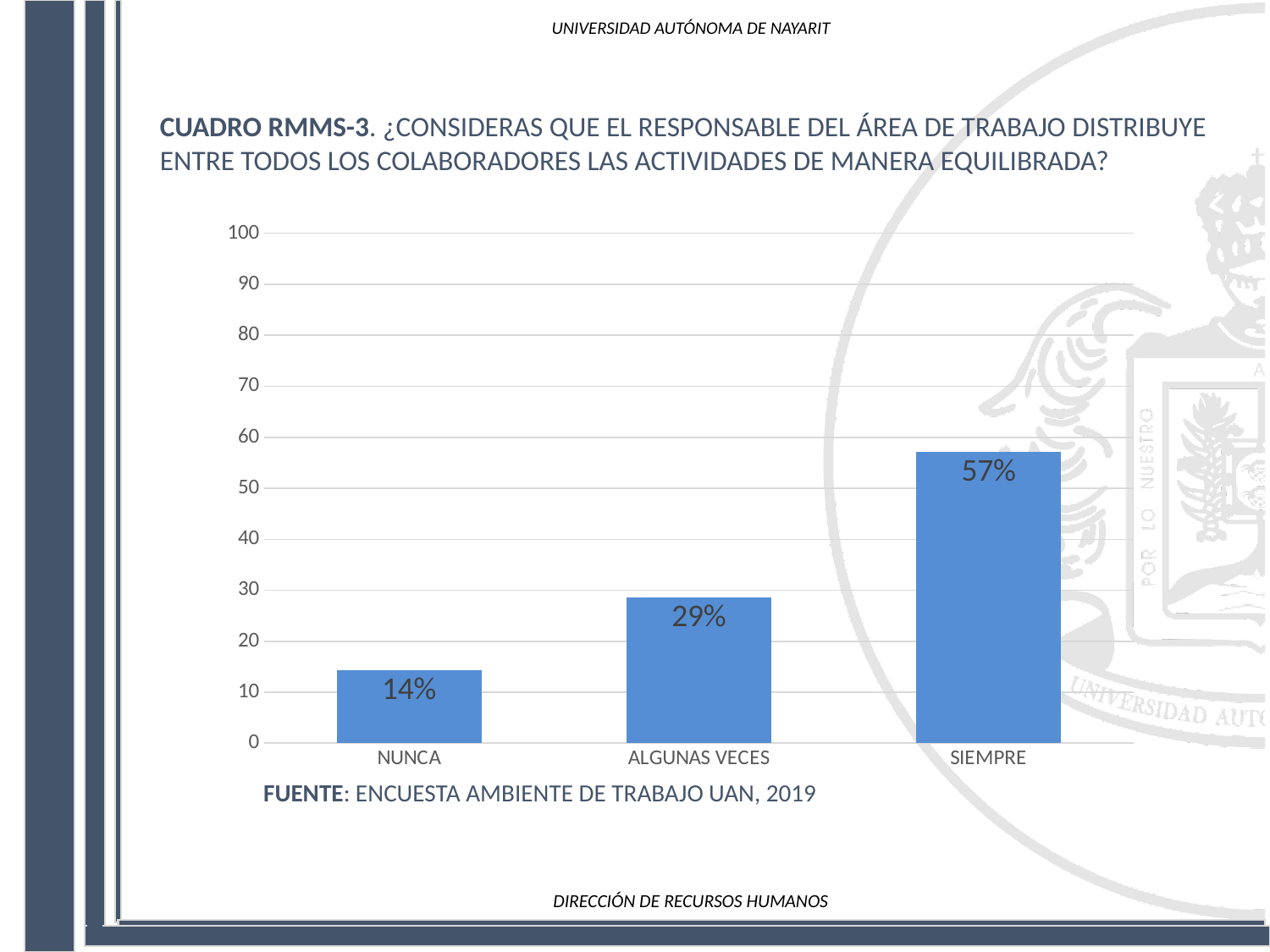
What is the value for NUNCA? 14% Which category has the lowest value? NUNCA Which category has the highest value? SIEMPRE How many categories are shown on the x axis? 3 Is the value for SIEMPRE greater or less than 50? greater Which is larger, the value for NUNCA or the value for ALGUNAS VECES? ALGUNAS VECES What is the difference between the values for ALGUNAS VECES and NUNCA? 15% What is the value for SIEMPRE? 57% Do the values rise or fall from left to right along the x axis? rise What is the difference between the values for SIEMPRE and ALGUNAS VECES? 28% What is the value for ALGUNAS VECES? 29% What kind of chart is shown on the slide? bar chart